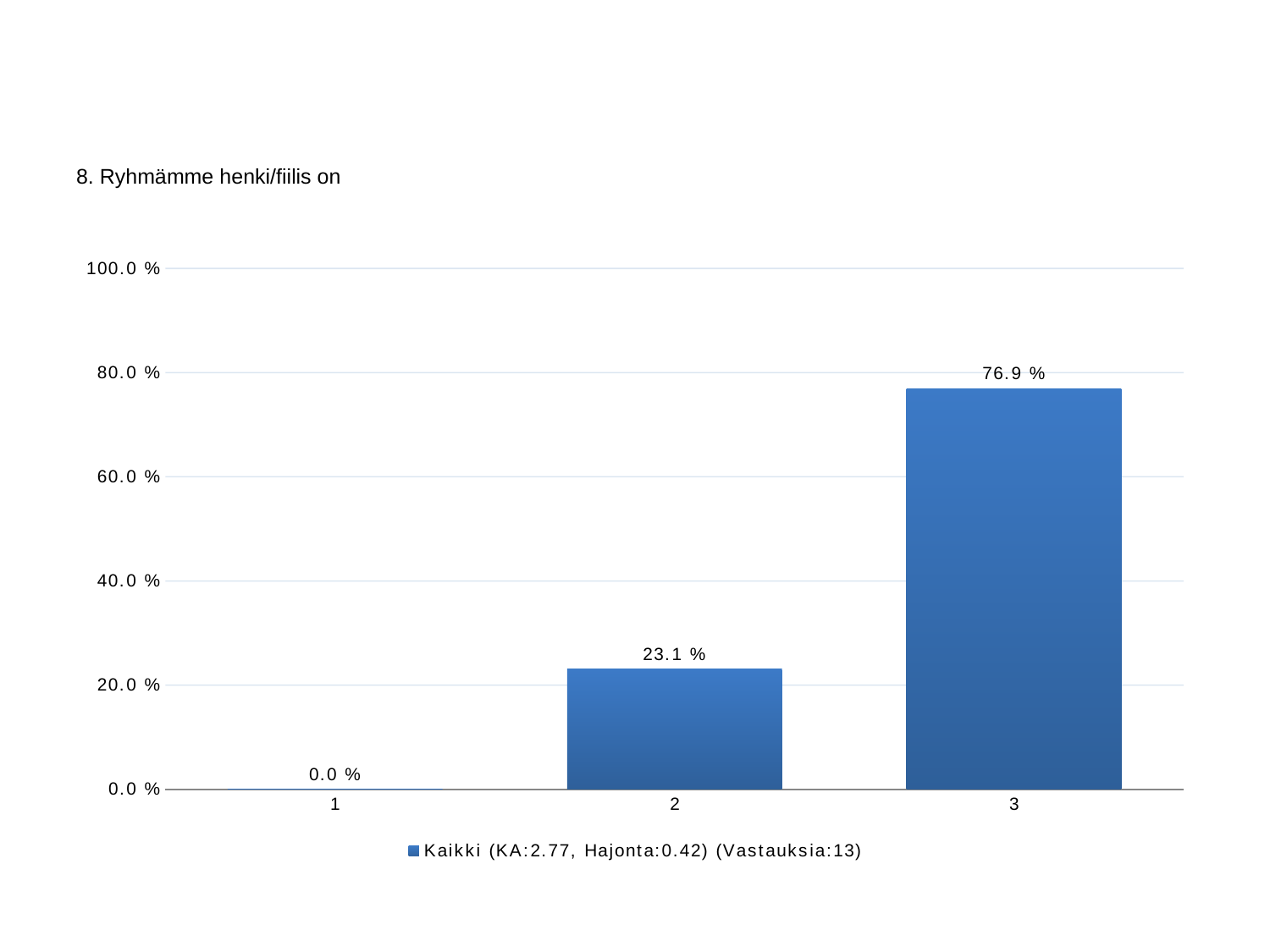
Is the value for category 3 greater or less than 60.0 %? greater Which is larger, the value for category 2 or category 3? category 3 How many series does the legend list? 1 Which category has the lowest value? 1 How many categories are shown on the x axis? 3 What kind of chart is shown? bar chart What is the title of the chart? 8. Ryhmämme henki/fiilis on What is the value for category 1? 0.0 % What is the value for category 2? 23.1 % What is the value for category 3? 76.9 % Which category has the highest value? 3 What is the difference between the values for category 3 and category 2? 53.8 %